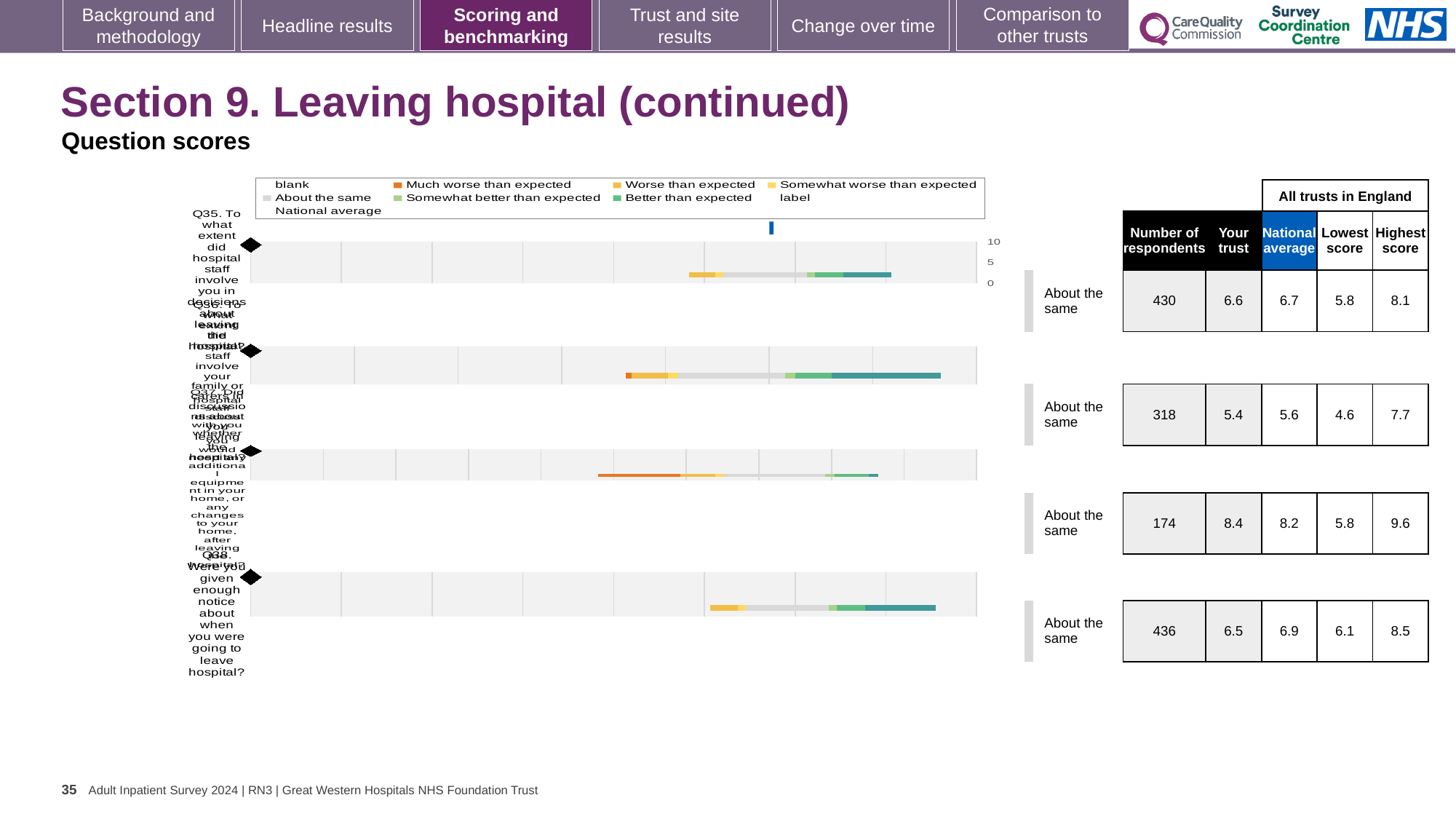
For Q38, what is the difference between the highest score and the lowest score across all trusts in England? 2.4 What is the highest score across all trusts in England shown for Q38? 8.5 What benchmark category is shown next to the chart for Q35? About the same How many respondents are listed for Q38 (given enough notice about when you were going to leave hospital)? 436 What is the lowest score across all trusts in England shown for Q35? 5.8 In the table beside the chart, what is the 'Your trust' score for Q35 (involving you in decisions about leaving hospital)? 6.6 In the chart legend, which category is shown in orange? Much worse than expected What is the national average score shown for Q35? 6.7 What kind of chart is used to show the question scores on this slide? bar chart For Q35, which is larger: the 'Your trust' score or the national average? National average How many question rows are plotted in the chart? 4 Which question row has the highest 'Your trust' score in the table? The third row (8.4)